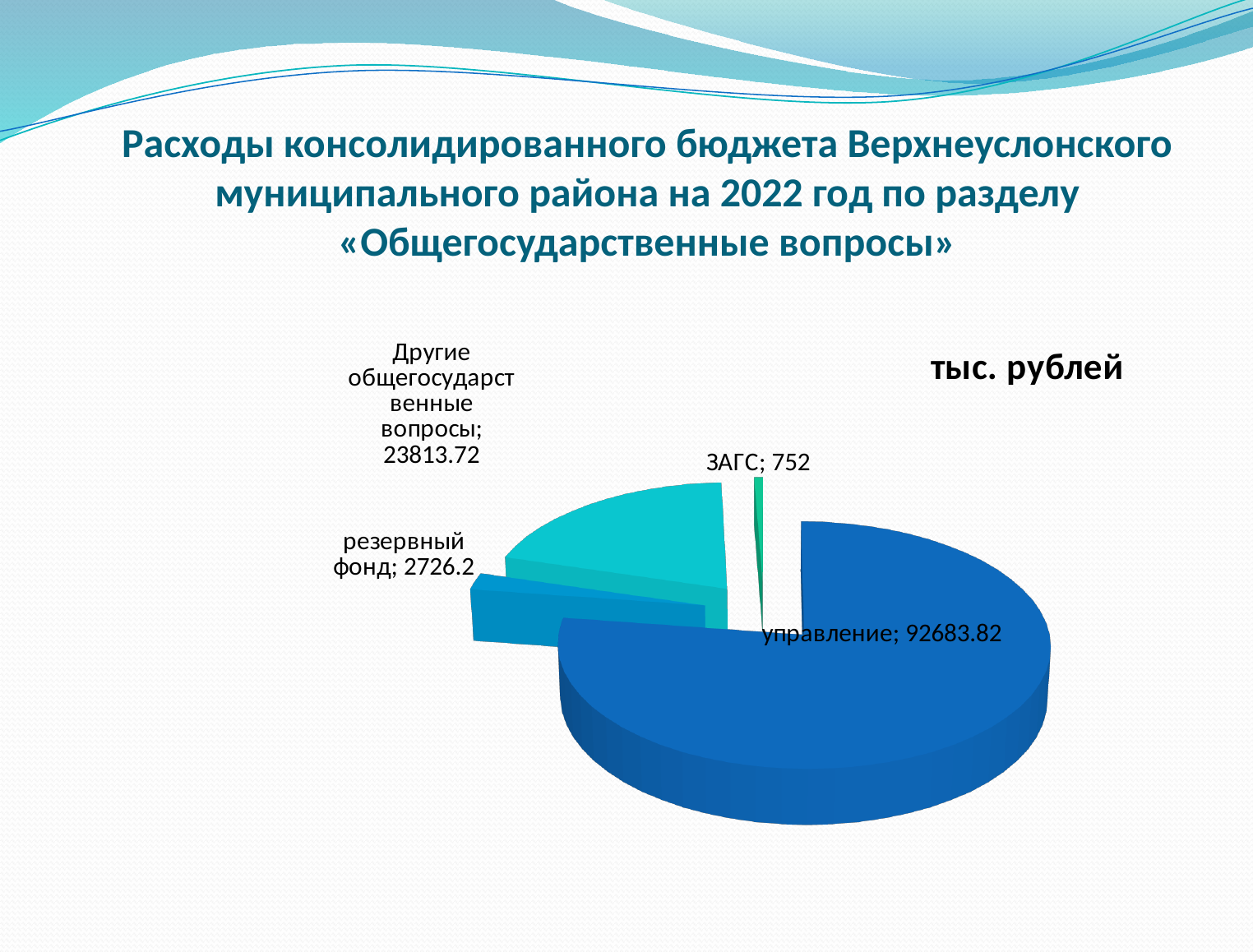
How many slices does the pie chart have? 4 Which category has the largest slice of the pie? управление What is the value for управление? 92683.82 What is the value for ЗАГС? 752 Which category has the smallest slice of the pie? ЗАГС What is the difference between the values for резервный фонд and ЗАГС? 1974.2 What is the value for Другие общегосударственные вопросы? 23813.72 In what units are the values on the chart given? тыс. рублей What is the value for резервный фонд? 2726.2 What type of chart is shown on the slide? pie chart What is the difference between the values for управление and Другие общегосударственные вопросы? 68870.1 Which is larger, the value for резервный фонд or the value for ЗАГС? резервный фонд